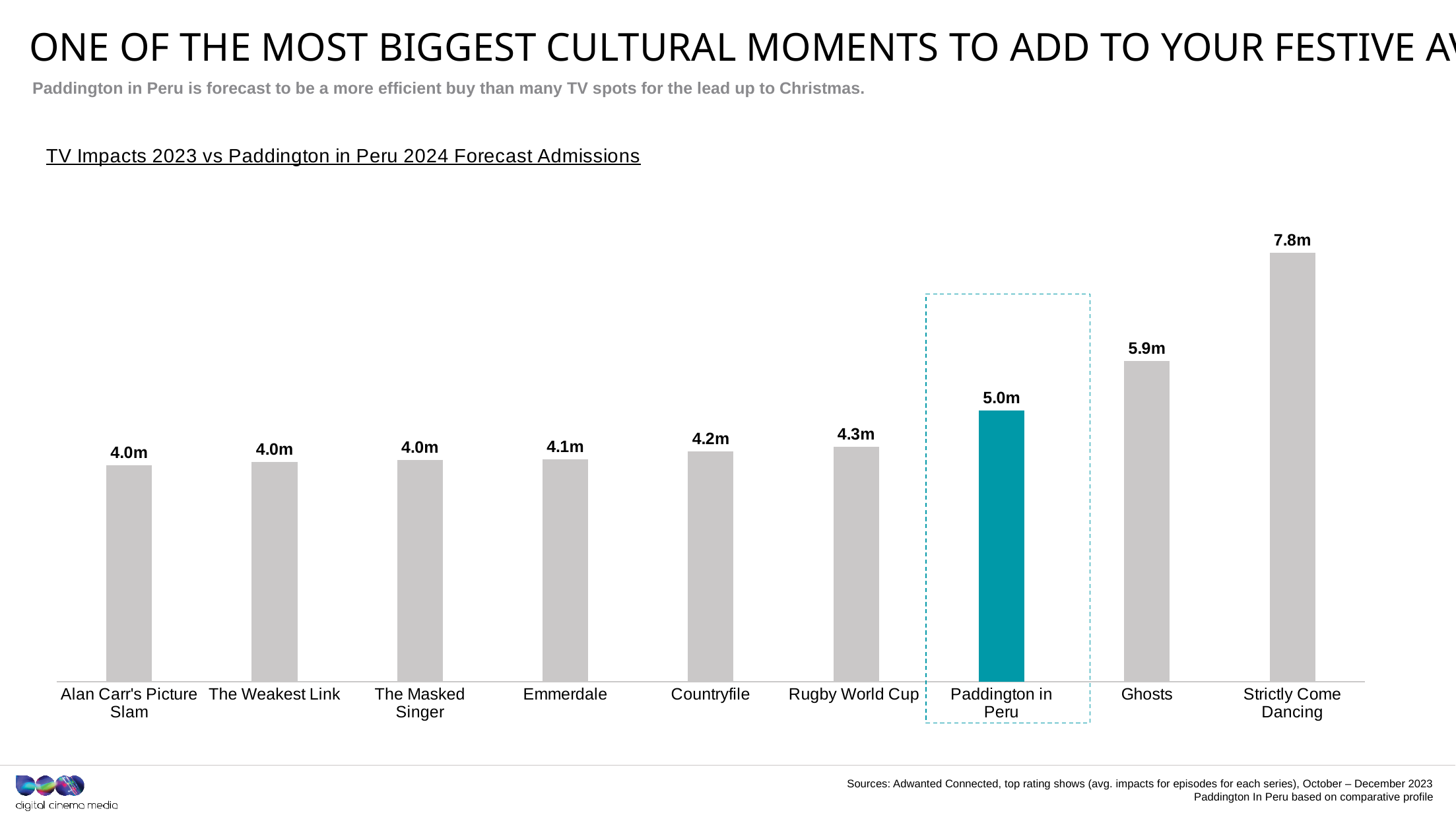
How many categories are shown in the chart? 9 What is the value for Paddington in Peru? 5.0m Do the values rise or fall from left to right along the x axis? Rise Which category has the highest value? Strictly Come Dancing What is the difference between Strictly Come Dancing and Paddington in Peru? 2.8m Which bar is highlighted in teal rather than grey? Paddington in Peru Which is larger, Countryfile or Paddington in Peru? Paddington in Peru What kind of chart is shown on the slide? Bar chart What is the difference between Ghosts and Paddington in Peru? 0.9m What is the value for Rugby World Cup? 4.3m What is the value for Emmerdale? 4.1m What is the value for Ghosts? 5.9m